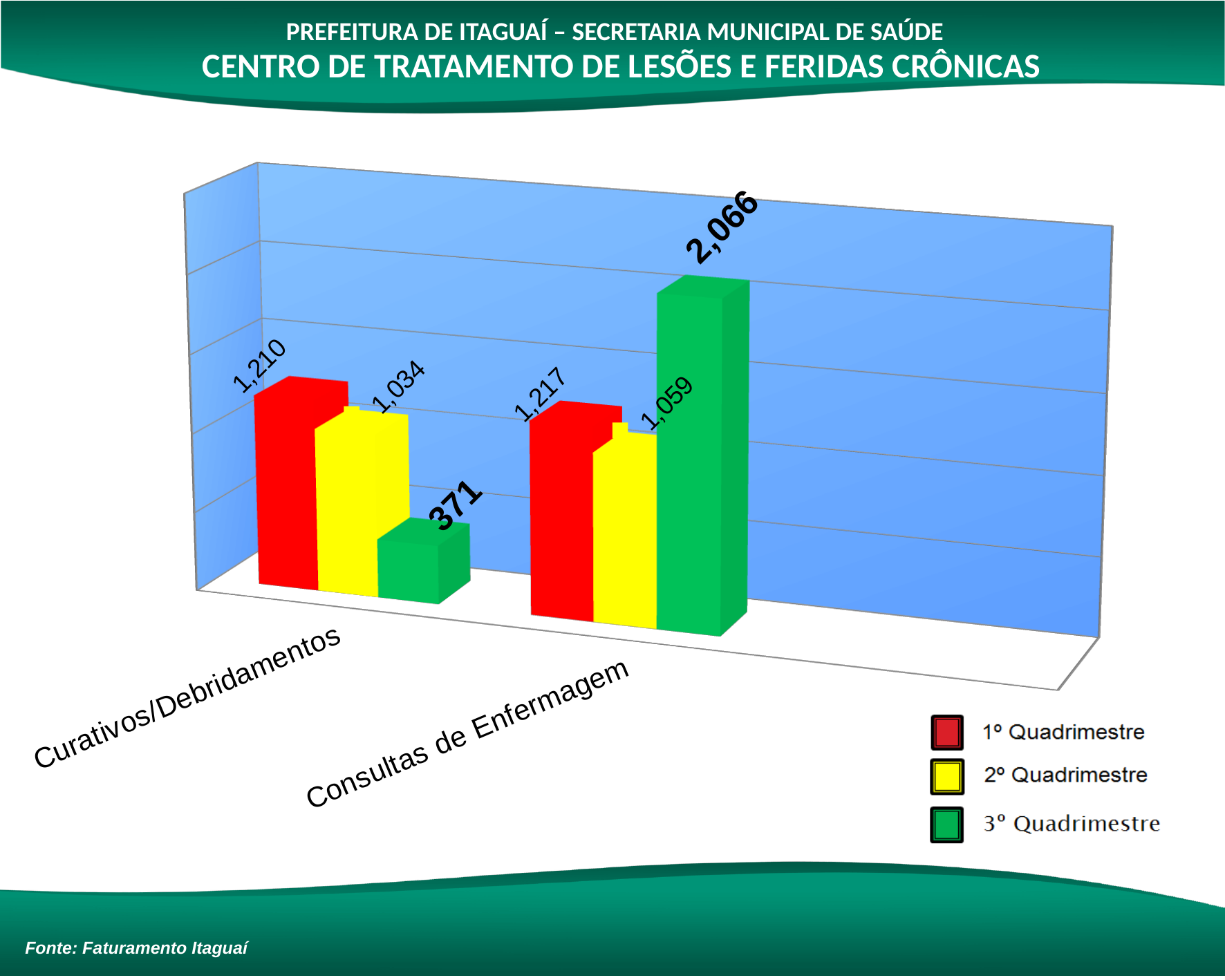
What is the value for Consultas de Enfermagem in the 2º Quadrimestre? 1,059 Which quadrimestre has the highest value for Consultas de Enfermagem? 3º Quadrimestre What is the value for Consultas de Enfermagem in the 3º Quadrimestre? 2,066 What is the value for Curativos/Debridamentos in the 3º Quadrimestre? 371 What kind of chart is shown on the slide? Bar chart Which is larger: the 2º Quadrimestre value for Curativos/Debridamentos or for Consultas de Enfermagem? Consultas de Enfermagem What is the difference between the 3º Quadrimestre values for Consultas de Enfermagem and Curativos/Debridamentos? 1,695 Which quadrimestre has the lowest value for Curativos/Debridamentos? 3º Quadrimestre What is the value for Curativos/Debridamentos in the 1º Quadrimestre? 1,210 How many series does the legend list? 3 How many categories are shown on the x axis? 2 What is the difference between the 1º and 2º Quadrimestre values for Curativos/Debridamentos? 176